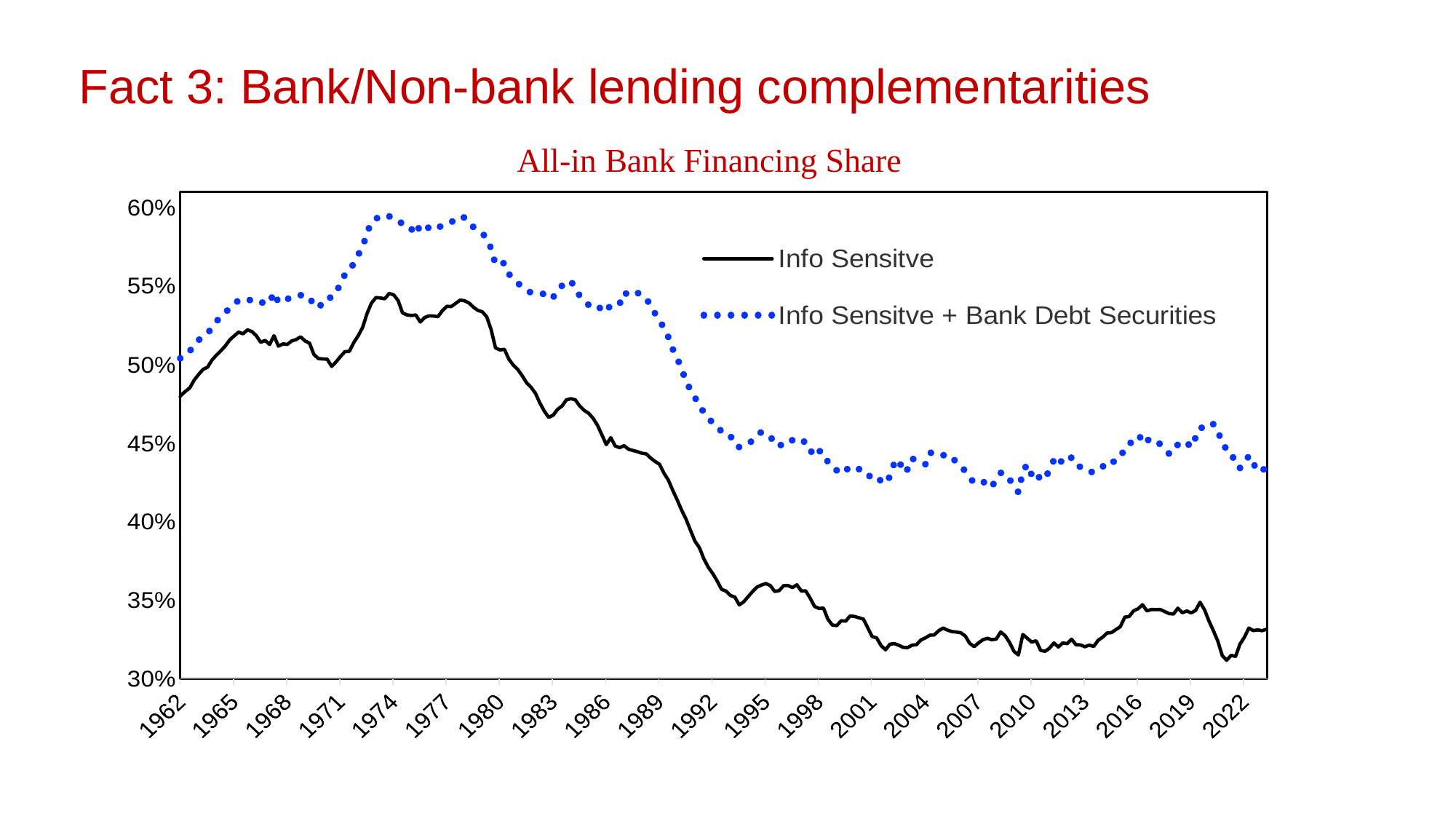
Is the value for Info Sensitve in 2022 greater or less than 35%? less How many year labels are shown on the x axis? 21 What is the title of the chart? All-in Bank Financing Share Is the value for Info Sensitve in 1962 greater or less than 50%? less What kind of chart is shown on the slide? line chart Which series is drawn with a blue dotted line? Info Sensitve + Bank Debt Securities Is the value for Info Sensitve in 1992 greater or less than 40%? less Does the Info Sensitve series rise or fall between 1977 and 1992? fall Which series has the higher value in 2001, Info Sensitve or Info Sensitve + Bank Debt Securities? Info Sensitve + Bank Debt Securities How many series does the legend list? 2